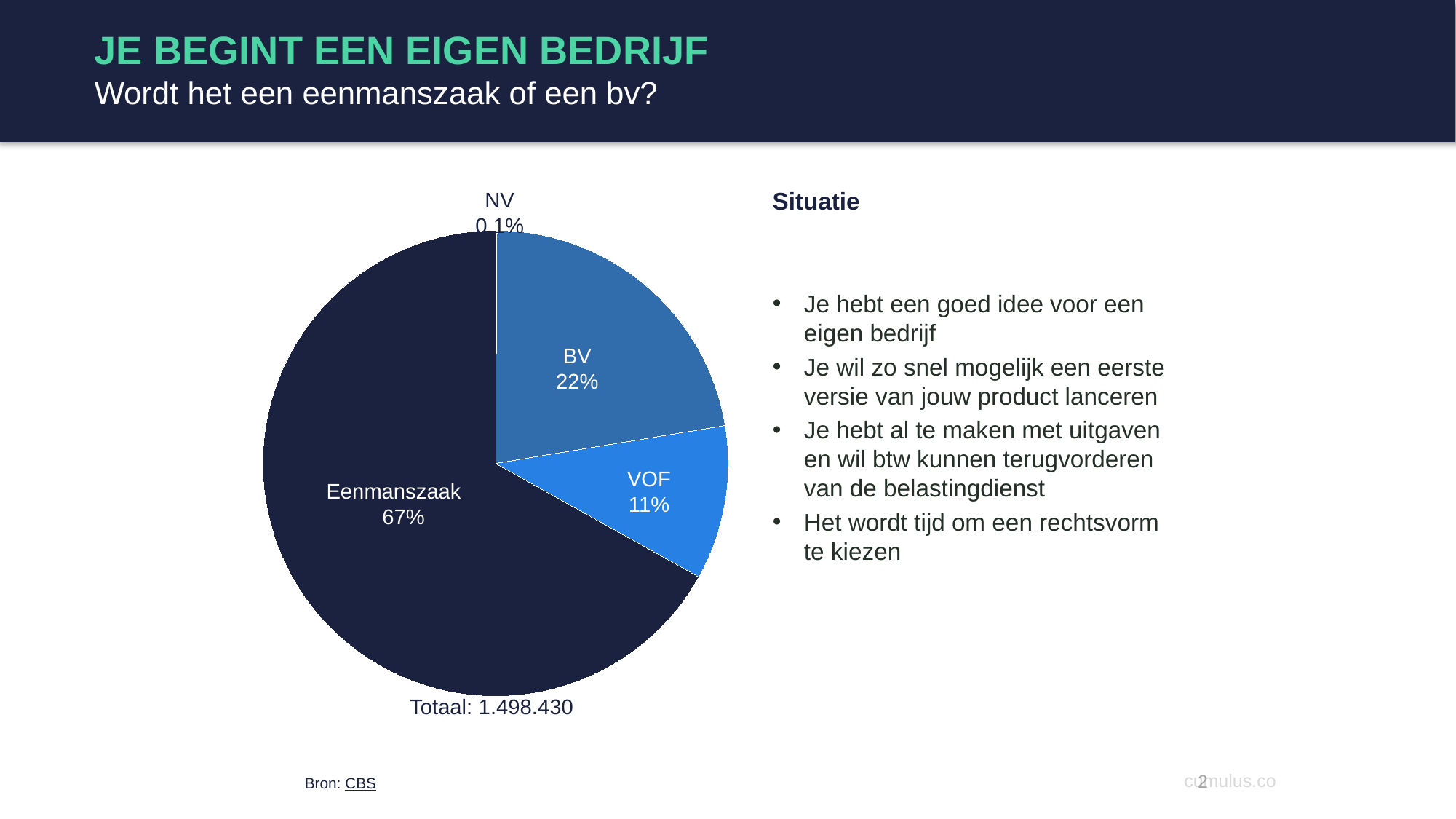
What percentage is shown for NV? 0.1% What is the difference in percentage points between BV and VOF? 11 What is the difference in percentage points between Eenmanszaak and BV? 45 What percentage is shown for BV? 22% What kind of chart is shown on the slide? Pie chart What total is printed below the pie chart? Totaal: 1.498.430 Which is larger, the share for BV or the share for VOF? BV Which category has the largest slice of the pie? Eenmanszaak Which category has the smallest slice of the pie? NV What percentage is shown for VOF? 11% How many categories are shown in the pie chart? 4 What share of the pie does Eenmanszaak hold? 67%